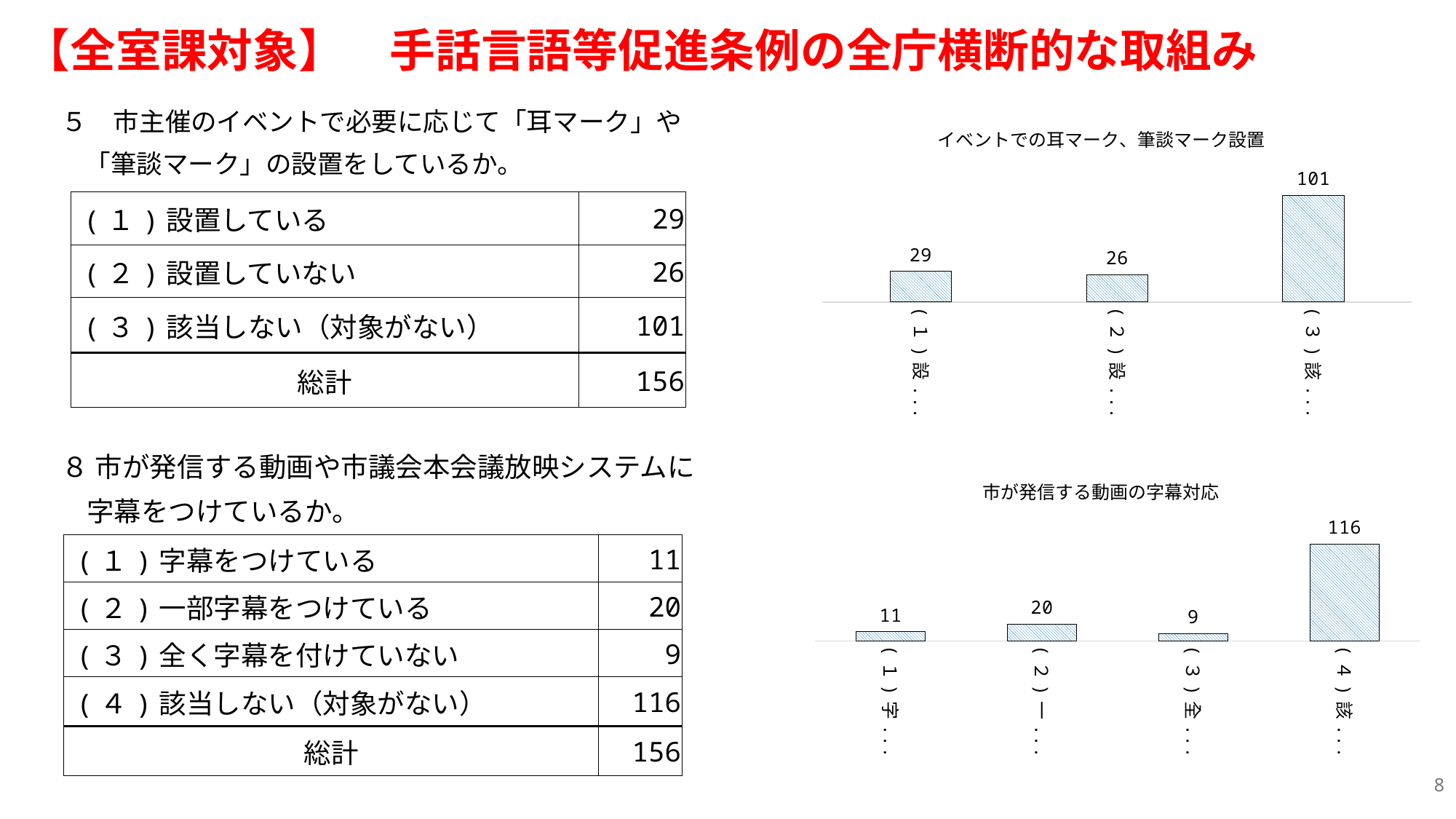
In the chart titled 市が発信する動画の字幕対応, what is the difference between the values for category (2) and category (3)? 11 In the chart titled 市が発信する動画の字幕対応, which category has the lowest value? (3) In the chart titled 市が発信する動画の字幕対応, how many categories are plotted? 4 In the chart titled イベントでの耳マーク、筆談マーク設置, what is the difference between the values for category (3) and category (1)? 72 In the chart titled 市が発信する動画の字幕対応, which is larger, the value for category (1) or category (2)? (2) In the chart titled イベントでの耳マーク、筆談マーク設置, which category has the lowest value? (2) In the chart titled イベントでの耳マーク、筆談マーク設置, how many categories are plotted? 3 In the chart titled イベントでの耳マーク、筆談マーク設置, what is the value for category (3)? 101 In the chart titled 市が発信する動画の字幕対応, which category has the highest value? (4) In the chart titled イベントでの耳マーク、筆談マーク設置, what is the value for category (1)? 29 What kind of chart is the chart titled 市が発信する動画の字幕対応? bar chart In the chart titled 市が発信する動画の字幕対応, what is the value for category (2)? 20